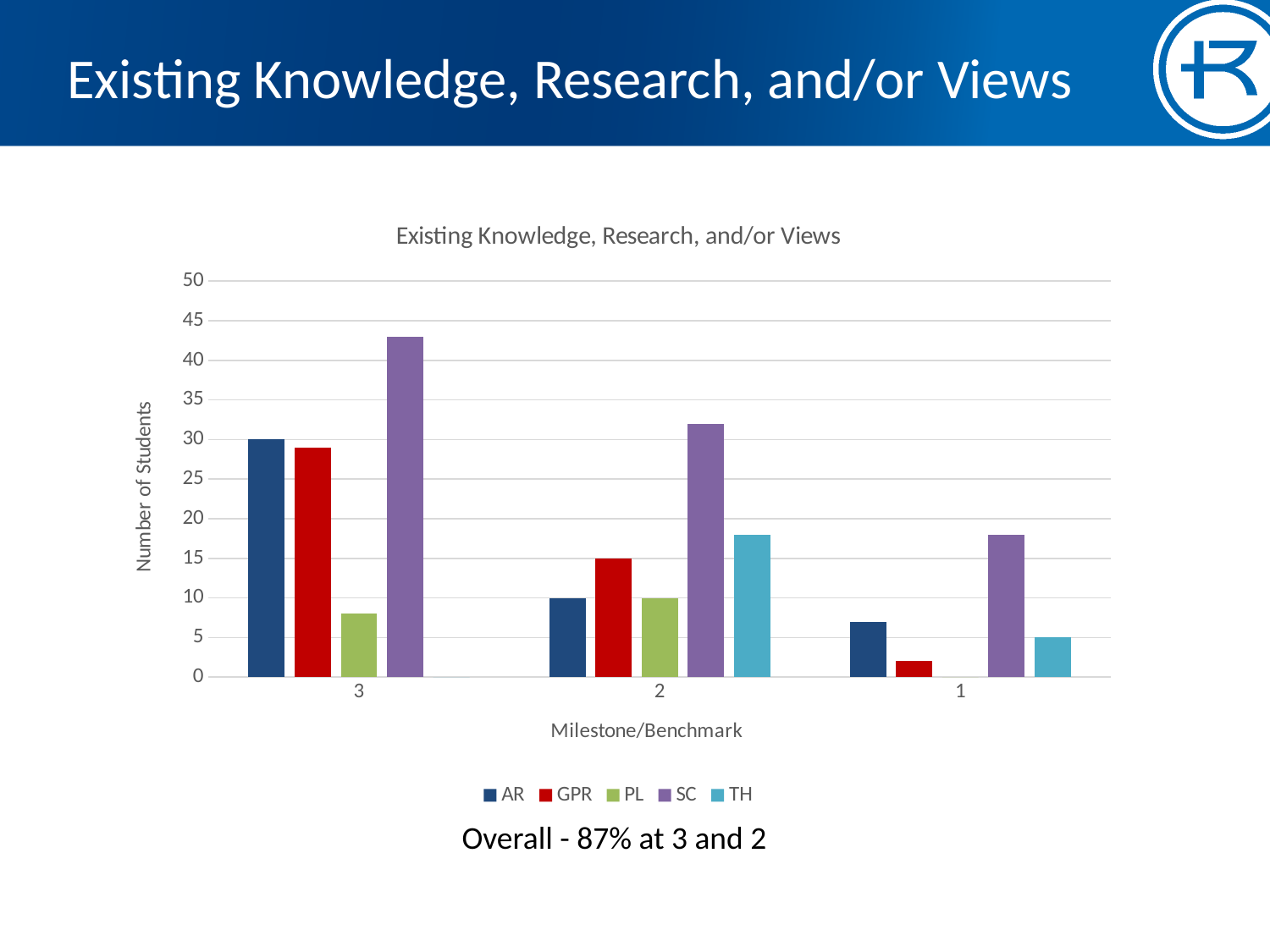
How many series does the legend list? 5 How many milestone/benchmark categories are shown on the x axis? 3 Is the value for TH at milestone 2 greater or less than 20? less What is the value for TH at milestone 1? 5 Is the value for SC at milestone 3 greater or less than 40? greater Which series has the highest value at milestone 3? SC Which series has the lowest value at milestone 1? PL What is the value for AR at milestone 3? 30 What is the value for GPR at milestone 2? 15 What type of chart is shown on the slide? bar chart What is the title of the y axis? Number of Students Which is larger: SC at milestone 3 or SC at milestone 2? SC at milestone 3